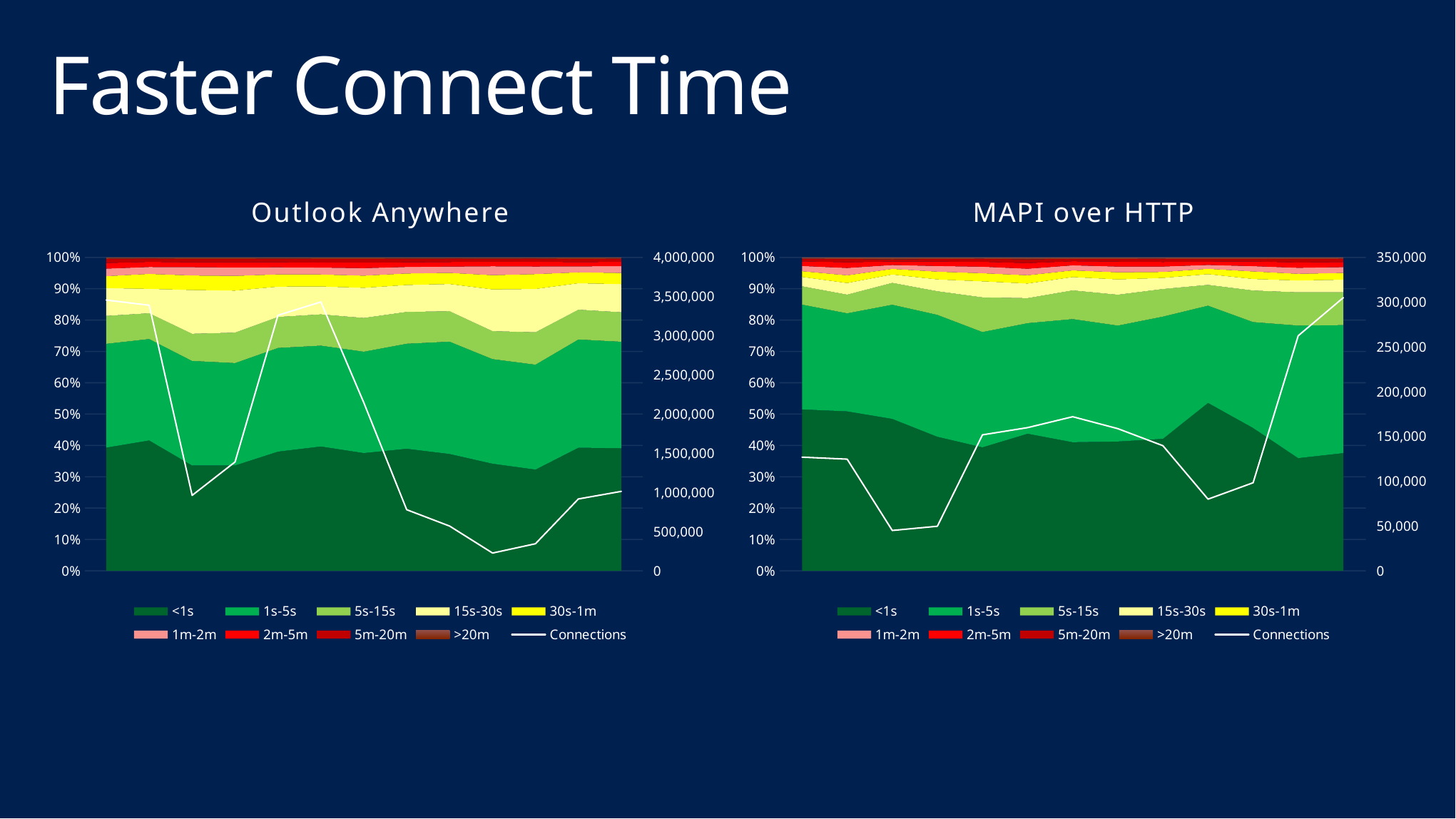
In the MAPI over HTTP chart, how many series does the legend list? 10 In the MAPI over HTTP chart, is the lowest point of the Connections line greater or less than 100,000? less What is the title of the chart on the right of the slide? MAPI over HTTP What kind of chart is the Outlook Anywhere chart? Stacked area chart with a line In the Outlook Anywhere chart, is the peak of the Connections line greater or less than 3,000,000? greater In the MAPI over HTTP chart, is the peak of the Connections line greater or less than 250,000? greater What is the title of the chart on the left of the slide? Outlook Anywhere In the MAPI over HTTP chart, what is the highest value shown on the right-hand axis? 350,000 Which chart has the larger maximum value on its right-hand axis, Outlook Anywhere or MAPI over HTTP? Outlook Anywhere In the Outlook Anywhere chart, what is the highest value shown on the right-hand axis? 4,000,000 In the Outlook Anywhere chart, how many series does the legend list? 10